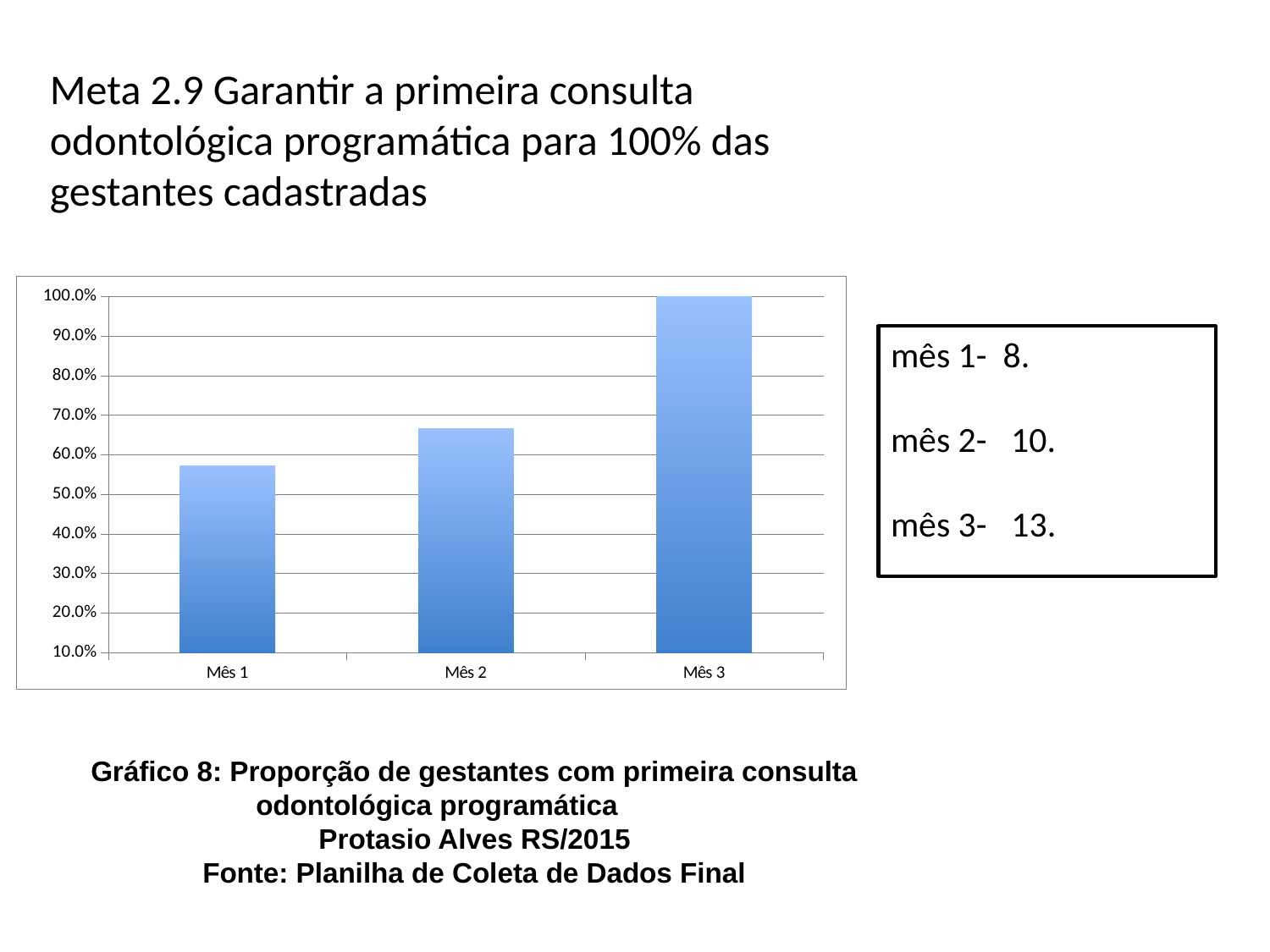
How many bars (categories) does the chart show? 3 What is the value for Mês 3? 100.0% Which month has the highest value in the chart? Mês 3 Is the value for Mês 1 greater or less than 60.0%? less Is the value for Mês 2 greater or less than 60.0%? greater What kind of chart is shown on the slide? bar chart What is the highest value shown on the vertical axis of the chart? 100.0% Is the value for Mês 1 greater or less than 50.0%? greater Do the values rise or fall from Mês 1 to Mês 3? rise Which is larger, the value for Mês 1 or the value for Mês 2? Mês 2 Which month has the lowest value in the chart? Mês 1